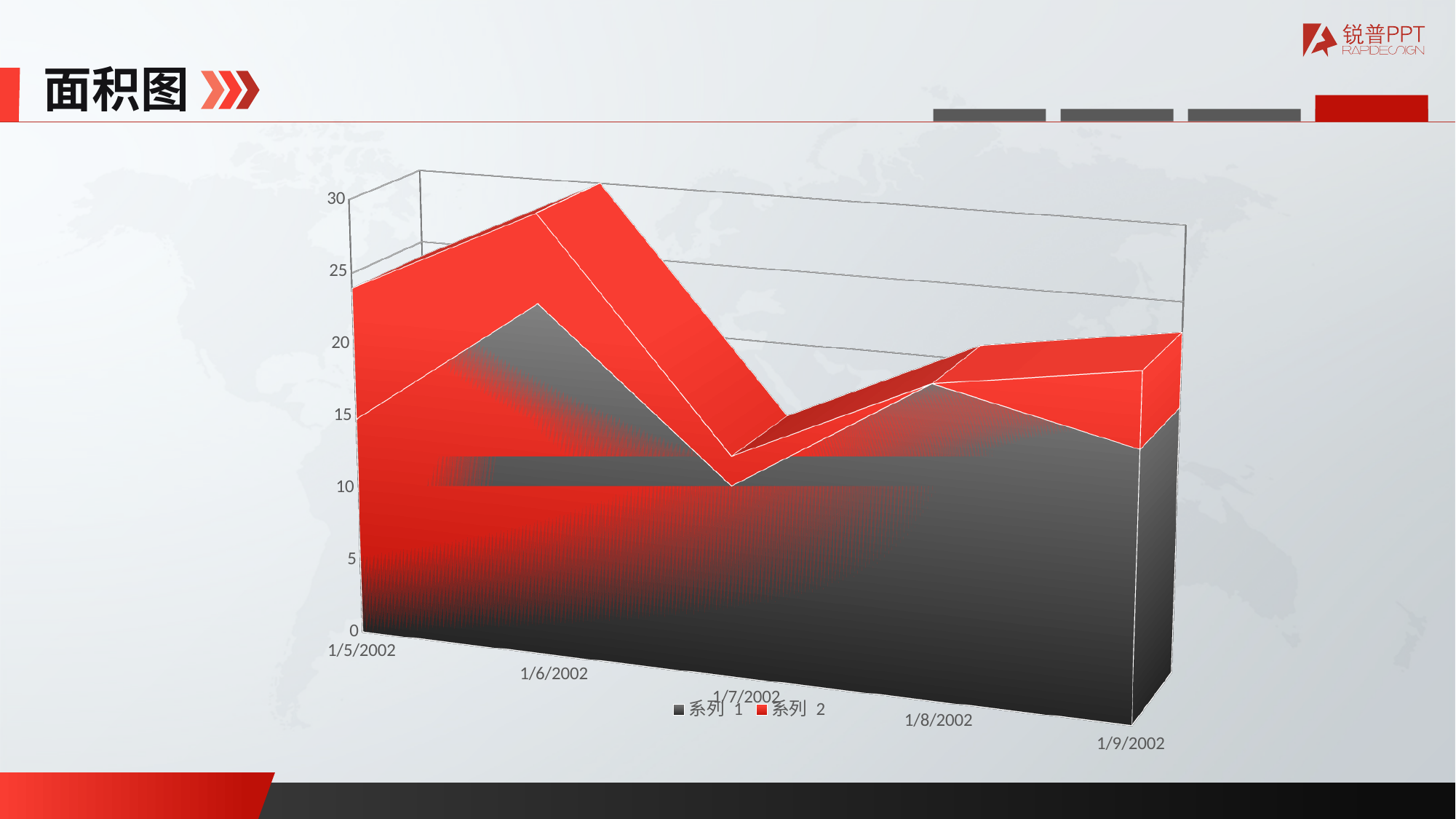
How many series does the legend list? 2 On which date does 系列 2 reach its lowest value? 1/7/2002 Is the value for 系列 2 at 1/6/2002 greater or less than 25? greater How many dates are shown along the x axis? 5 On which date does 系列 1 reach its highest value? 1/6/2002 What is the title of the slide? 面积图 Does 系列 2 rise or fall from 1/6/2002 to 1/7/2002? fall Is the value for 系列 2 at 1/5/2002 greater or less than 20? greater Which series is drawn in red? 系列 2 Is the value for 系列 1 at 1/7/2002 greater or less than 15? less On which date does 系列 2 reach its highest value? 1/6/2002 What kind of chart is shown on the slide? Area chart